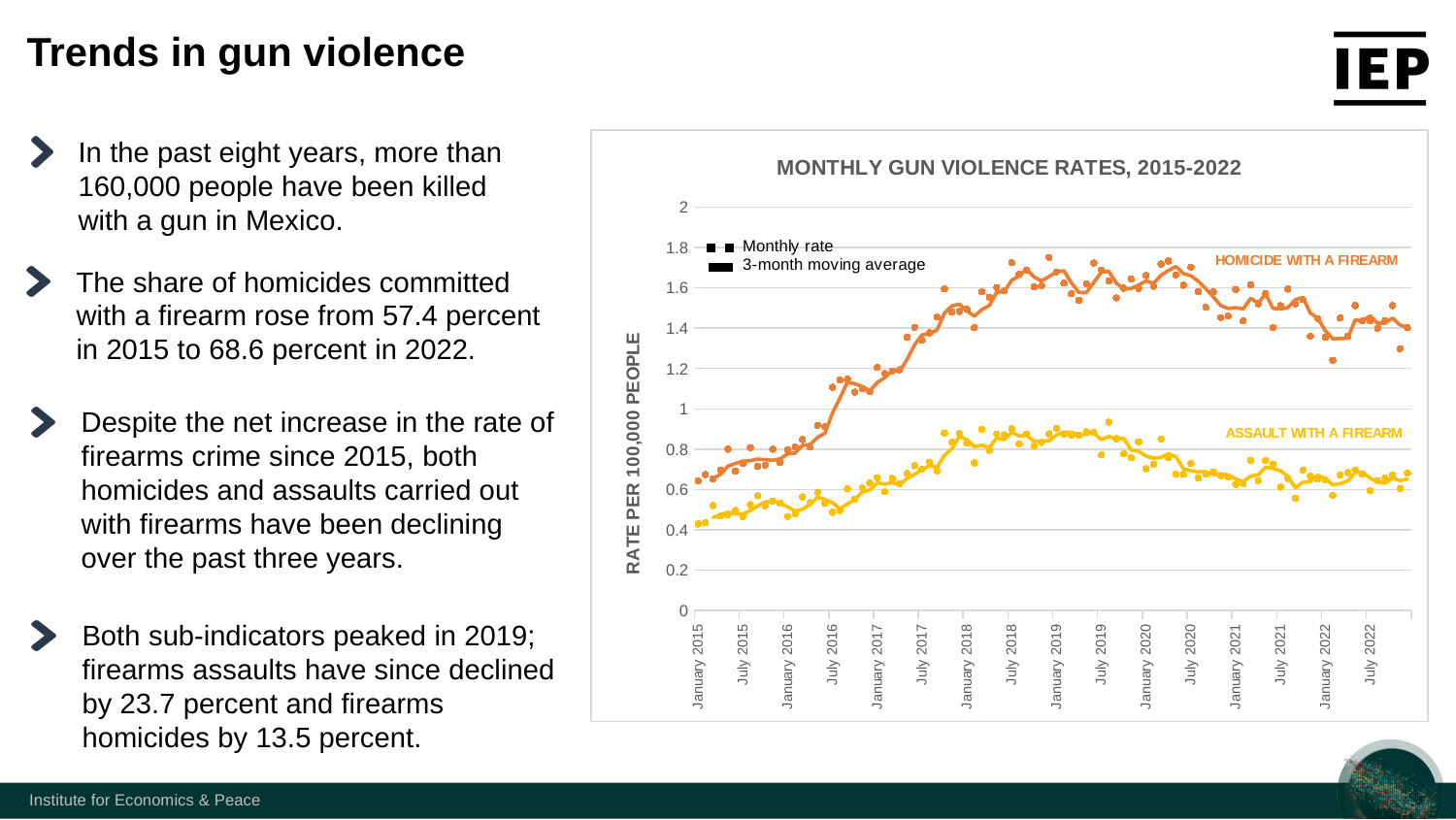
What is the title of the chart? MONTHLY GUN VIOLENCE RATES, 2015-2022 Did the homicide with a firearm rate rise or fall between January 2015 and January 2019? Rise Is the homicide with a firearm rate in July 2022 greater or less than 1.2? greater Is the homicide with a firearm rate in July 2018 greater or less than 1.4? greater Is the assault with a firearm rate in January 2015 greater or less than 0.6? less Did the assault with a firearm rate rise or fall between July 2019 and July 2022? Fall How many series are plotted in the chart? 4 Which series has the higher rate throughout the period, homicide with a firearm or assault with a firearm? Homicide with a firearm What kind of chart is shown on the slide? Line chart What is the label on the vertical axis of the chart? RATE PER 100,000 PEOPLE